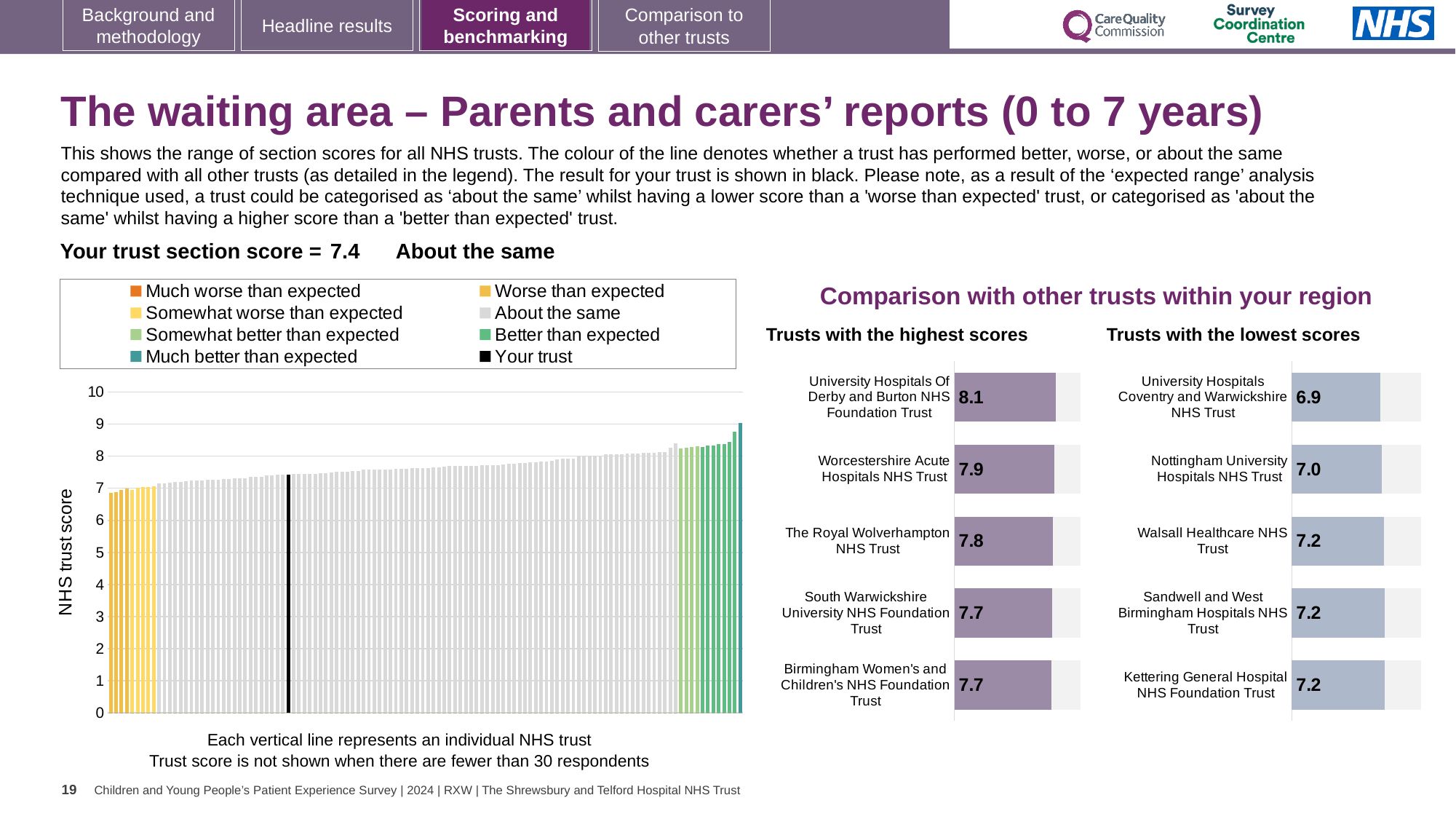
In the 'Trusts with the highest scores' chart, what is the score for The Royal Wolverhampton NHS Trust? 7.8 In the 'Trusts with the highest scores' chart, what is the score for University Hospitals Of Derby and Burton NHS Foundation Trust? 8.1 What is the y-axis label of the large chart on the left? NHS trust score In the 'Trusts with the lowest scores' chart, what is the score for Nottingham University Hospitals NHS Trust? 7.0 In the large chart on the left, is the value of the tallest bar greater or less than 8? greater How many trusts are shown in the 'Trusts with the lowest scores' chart? 5 In the large chart on the left, do the bars rise or fall from left to right? Rise In the 'Trusts with the lowest scores' chart, which is larger: the score for Walsall Healthcare NHS Trust or the score for University Hospitals Coventry and Warwickshire NHS Trust? Walsall Healthcare NHS Trust In the 'Trusts with the highest scores' chart, what is the difference between the scores of University Hospitals Of Derby and Burton NHS Foundation Trust and Worcestershire Acute Hospitals NHS Trust? 0.2 What kind of chart is the large chart on the left showing NHS trust scores? Bar chart In the 'Trusts with the lowest scores' chart, which trust has the lowest score? University Hospitals Coventry and Warwickshire NHS Trust In the 'Trusts with the highest scores' chart, which trust has the highest score? University Hospitals Of Derby and Burton NHS Foundation Trust